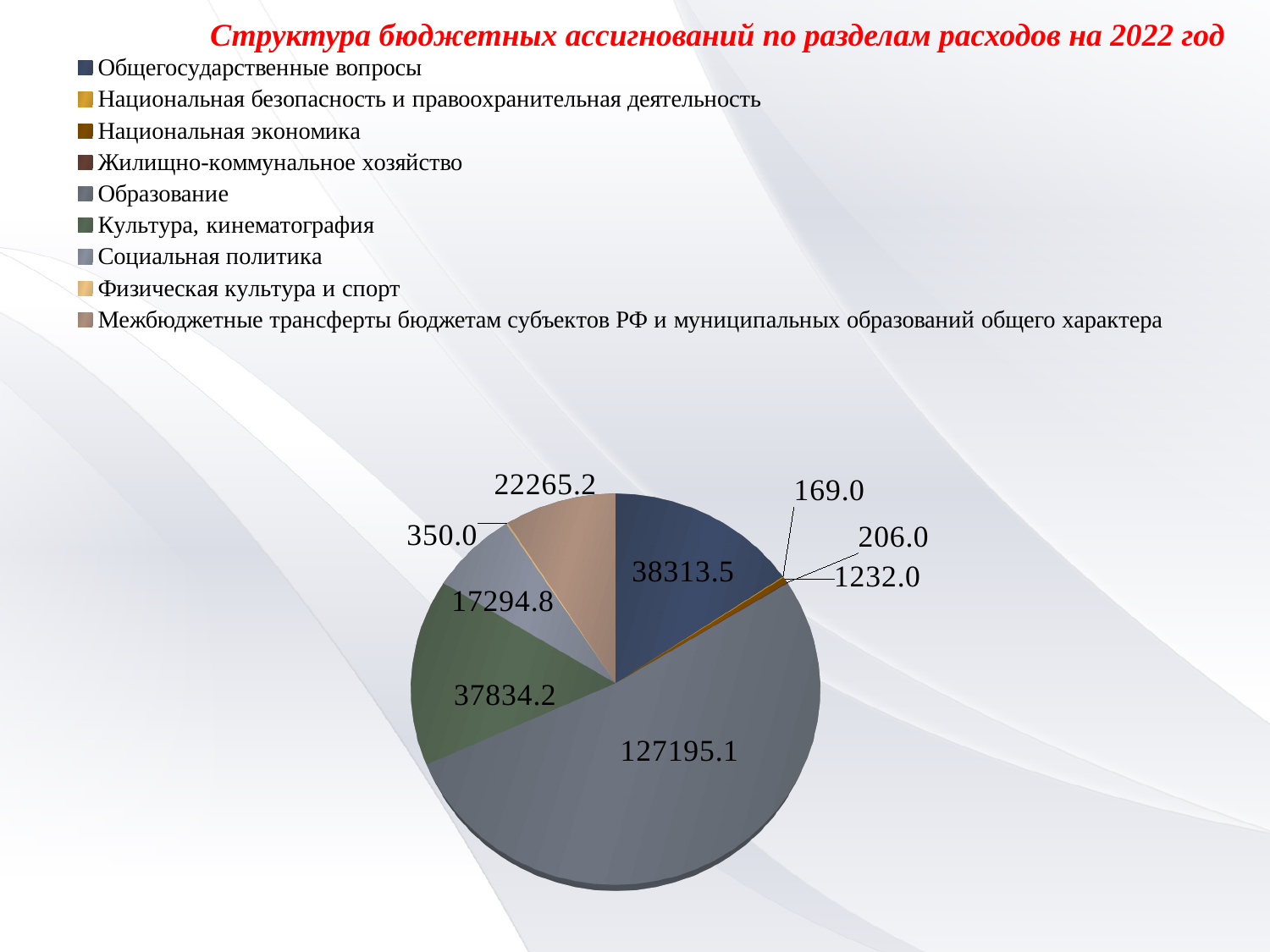
What is the value for Социальная политика? 17294.8 What is the difference between the values for Общегосударственные вопросы and Культура, кинематография? 479.3 Which is larger: the value for Межбюджетные трансферты or the value for Социальная политика? Межбюджетные трансферты What is the value for Межбюджетные трансферты бюджетам субъектов РФ и муниципальных образований общего характера? 22265.2 What is the title of the chart on the slide? Структура бюджетных ассигнований по разделам расходов на 2022 год What is the value for Образование in the pie chart? 127195.1 Which category has the smallest slice of the pie? Национальная безопасность и правоохранительная деятельность What is the value for Культура, кинематография? 37834.2 How many categories does the legend of the pie chart list? 9 What type of chart is shown on the slide? pie chart What is the value for Общегосударственные вопросы? 38313.5 Which category has the largest slice of the pie? Образование